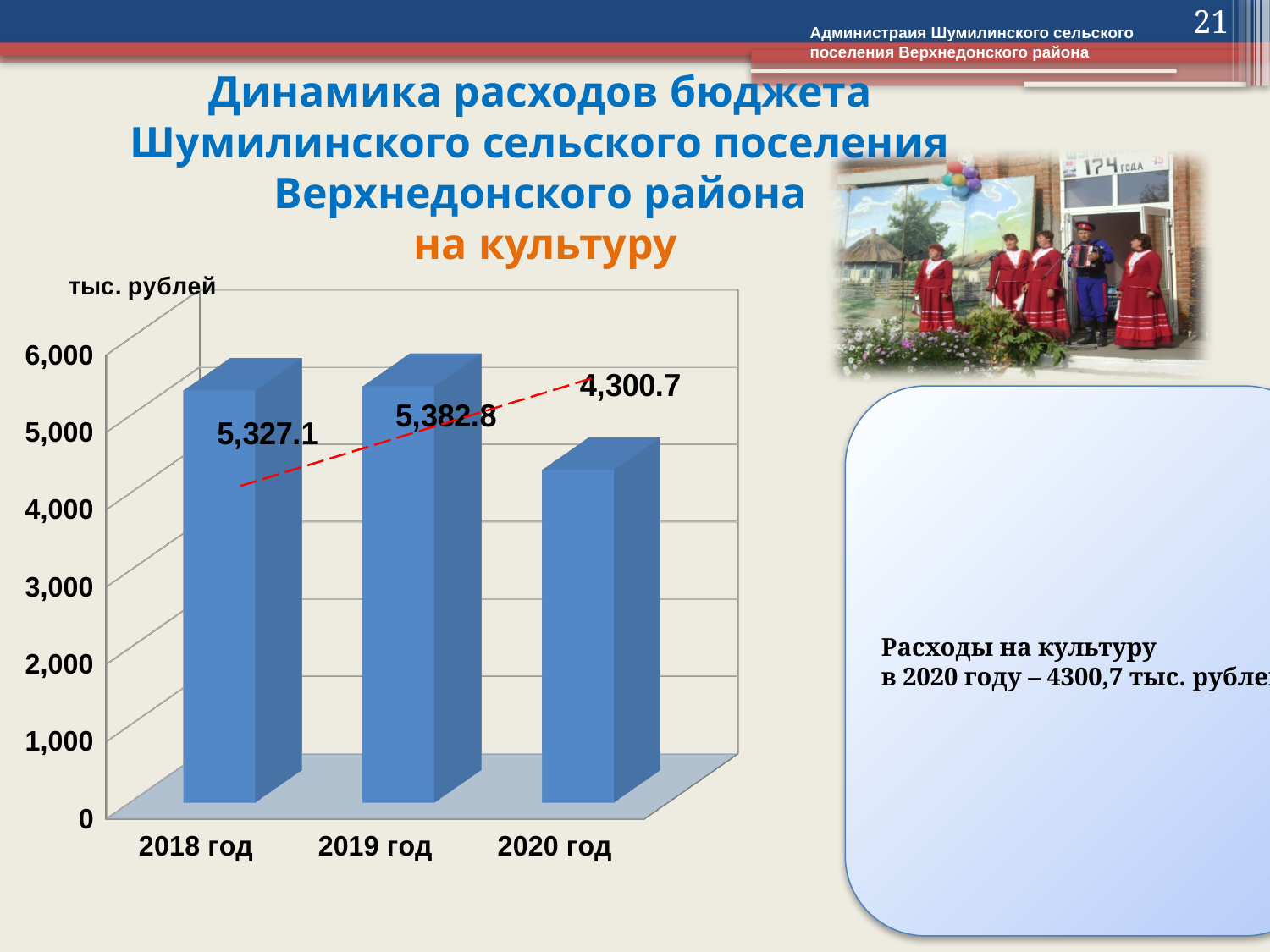
What kind of chart is shown on the slide? bar chart What unit label is shown above the vertical axis of the chart? тыс. рублей What is the value for 2020 год? 4,300.7 Is the value for 2020 год greater or less than 5,000? less Which is larger, the value for 2018 год or the value for 2020 год? 2018 год What is the value for 2019 год? 5,382.8 What is the difference between the values for 2018 год and 2020 год? 1,026.4 How many years are shown on the chart? 3 What is the difference between the values for 2019 год and 2020 год? 1,082.1 What is the value for 2018 год? 5,327.1 Which year has the highest value? 2019 год Which year has the lowest value? 2020 год